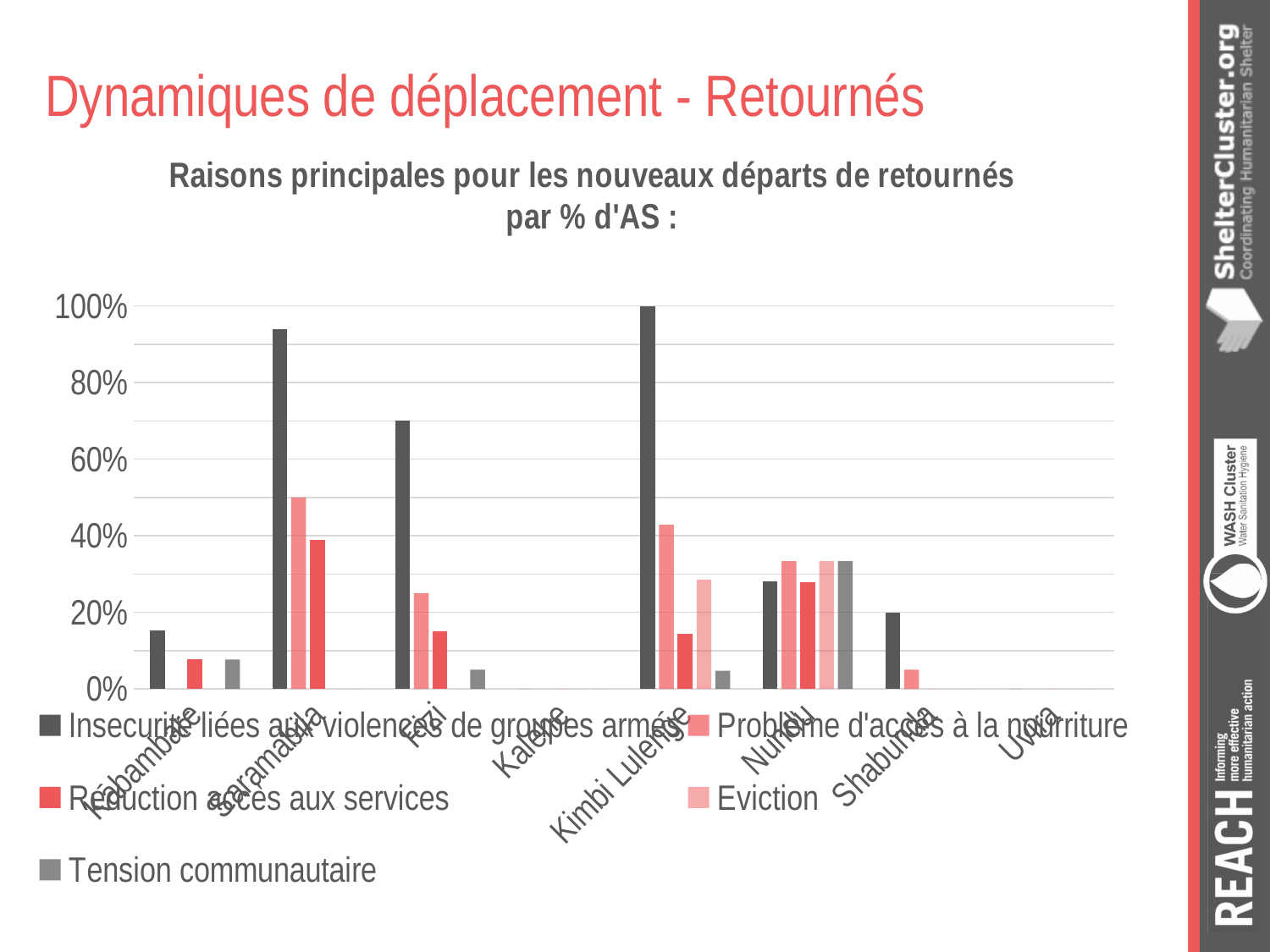
Which category has the highest bar for 'Insecurité liées aux violences de groupes armés'? Kimbi Lulenge What colour represents 'Tension communautaire' in the legend? grey Is the value for 'Insecurité liées aux violences de groupes armés' in Nundu greater or less than 40%? less Is the value for 'Insecurité liées aux violences de groupes armés' in Kabambare greater or less than 20%? less Which is larger, the 'Insecurité liées aux violences de groupes armés' value for Fizi or for Nundu? Fizi What kind of chart is shown on the slide? bar chart Is the value for 'Problème d'accès à la nourriture' in Kimbi Lulenge greater or less than 20%? greater How many categories are shown along the x axis? 8 How many series does the legend list? 5 What is the title of the chart? Raisons principales pour les nouveaux départs de retournés par % d'AS :